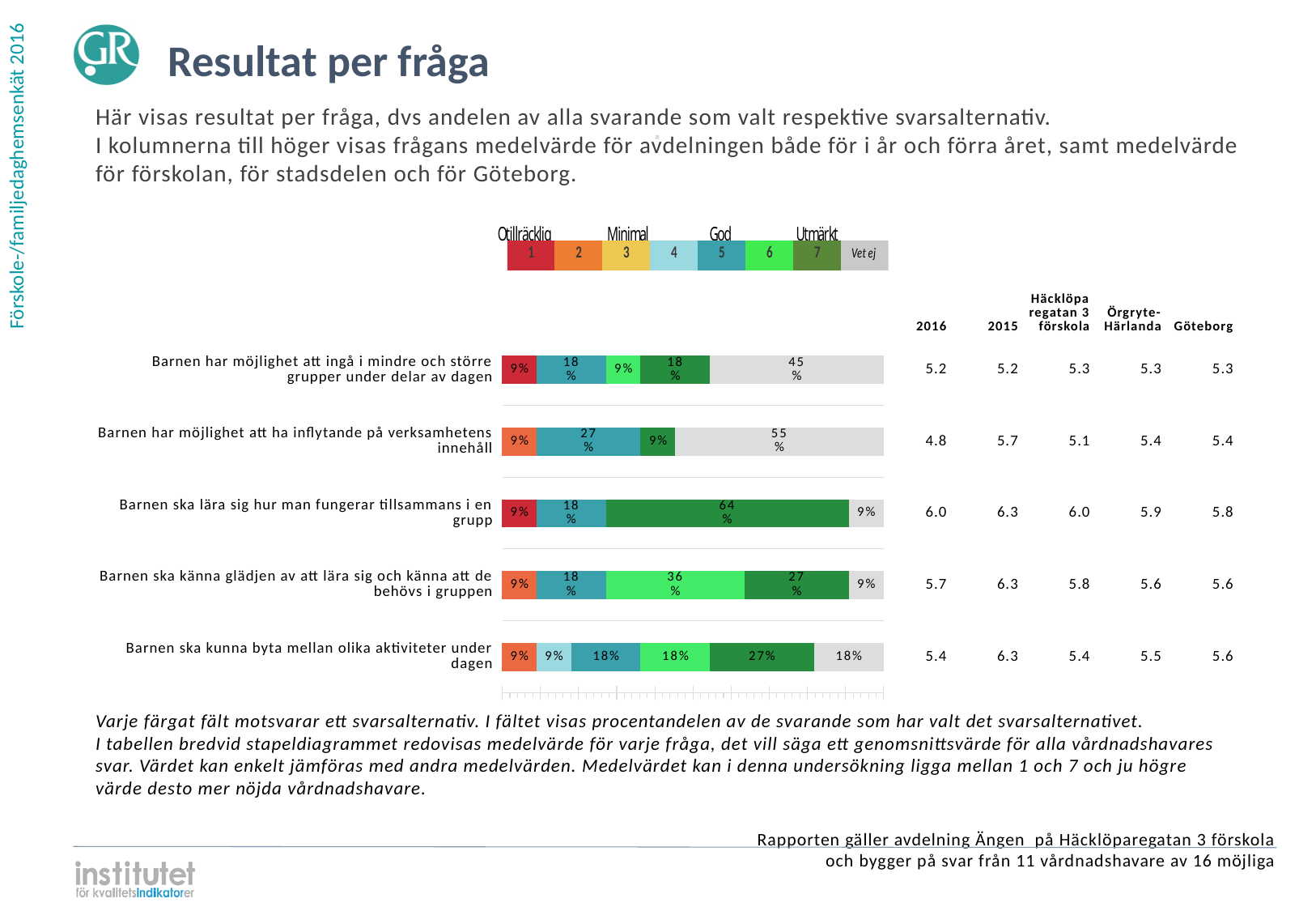
What is the 2016 mean value shown for 'Barnen har möjlighet att ha inflytande på verksamhetens innehåll'? 4.8 Is the dark green (answer 7) segment larger for 'Barnen ska känna glädjen av att lära sig och känna att de behövs i gruppen' or for 'Barnen har möjlighet att ha inflytande på verksamhetens innehåll'? Barnen ska känna glädjen av att lära sig och känna att de behövs i gruppen What percentage of respondents chose 'Vet ej' for 'Barnen har möjlighet att ha inflytande på verksamhetens innehåll'? 55% Which question has the largest 'Vet ej' (grey) share? Barnen har möjlighet att ha inflytande på verksamhetens innehåll What kind of chart is used to show the answer distribution per question? Stacked bar chart What percentage of respondents chose answer 7 (Utmärkt, dark green) for 'Barnen ska lära sig hur man fungerar tillsammans i en grupp'? 64% How many segments does the bar for 'Barnen ska kunna byta mellan olika aktiviteter under dagen' have? 6 Which question has the largest dark green (answer 7) segment? Barnen ska lära sig hur man fungerar tillsammans i en grupp What is the difference between the 'Vet ej' share for 'Barnen har möjlighet att ingå i mindre och större grupper under delar av dagen' (45%) and for 'Barnen ska lära sig hur man fungerar tillsammans i en grupp' (9%)? 36% How many answer alternatives does the legend above the chart list? 8 How many questions (bars) are shown in the chart? 5 What percentage chose answer 6 (light green) for 'Barnen ska känna glädjen av att lära sig och känna att de behövs i gruppen'? 36%